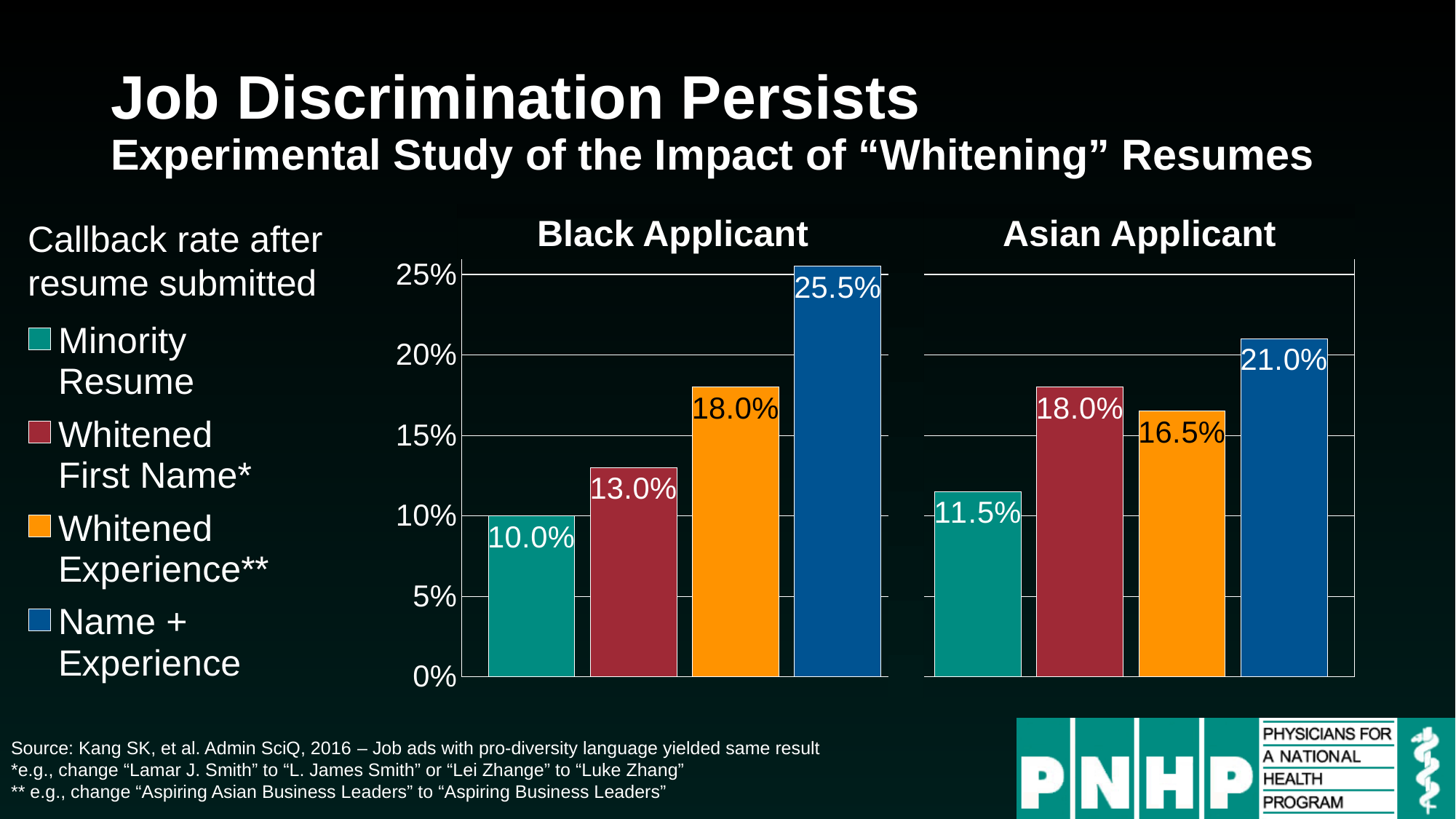
In the Asian Applicant chart, what is the difference between the callback rates for Whitened First Name and Whitened Experience? 1.5% How many series does the legend list? 4 In the Black Applicant chart, what is the callback rate for the Minority Resume? 10.0% In the Asian Applicant chart, what is the callback rate for Name + Experience? 21.0% What kind of chart is the Black Applicant chart? bar chart In the Black Applicant chart, which resume type has the highest callback rate? Name + Experience How many bars are shown in the Asian Applicant chart? 4 In the Asian Applicant chart, which is larger: the callback rate for Whitened First Name or for Whitened Experience? Whitened First Name In the Asian Applicant chart, which resume type has the lowest callback rate? Minority Resume In the Black Applicant chart, is the callback rate for Whitened First Name greater or less than 15%? less In the Black Applicant chart, what is the difference between the callback rates for Name + Experience and Minority Resume? 15.5% In the Asian Applicant chart, what is the callback rate for Whitened Experience? 16.5%